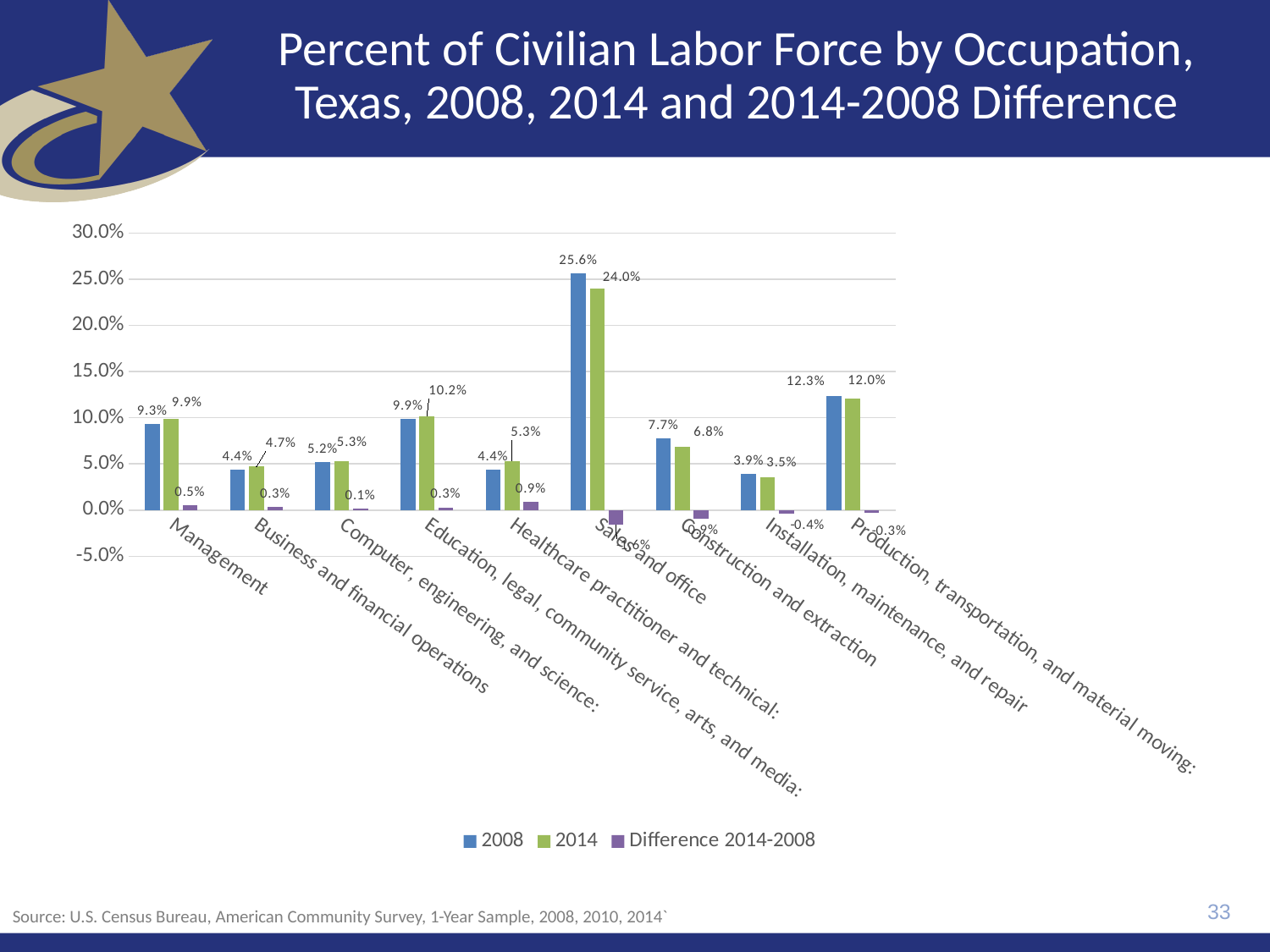
Which occupation has the highest 2008 value? Sales and office How many series does the legend list? 3 What was the 2014 value for Installation, maintenance, and repair? 3.5% Which occupation has the lowest 2014 value? Installation, maintenance, and repair What is the difference between the 2008 and 2014 values for Production, transportation, and material moving? 0.3% What is the Difference 2014-2008 value for Healthcare practitioner and technical? 0.9% Is the 2014 value for Education, legal, community service, arts, and media greater or less than 10.0%? greater Which is larger for Construction and extraction, the 2008 value or the 2014 value? 2008 What was the 2008 value for Management? 9.3% What kind of chart is shown on the slide? Bar chart How many occupation categories are shown on the chart? 9 What was the 2014 value for Sales and office? 24.0%